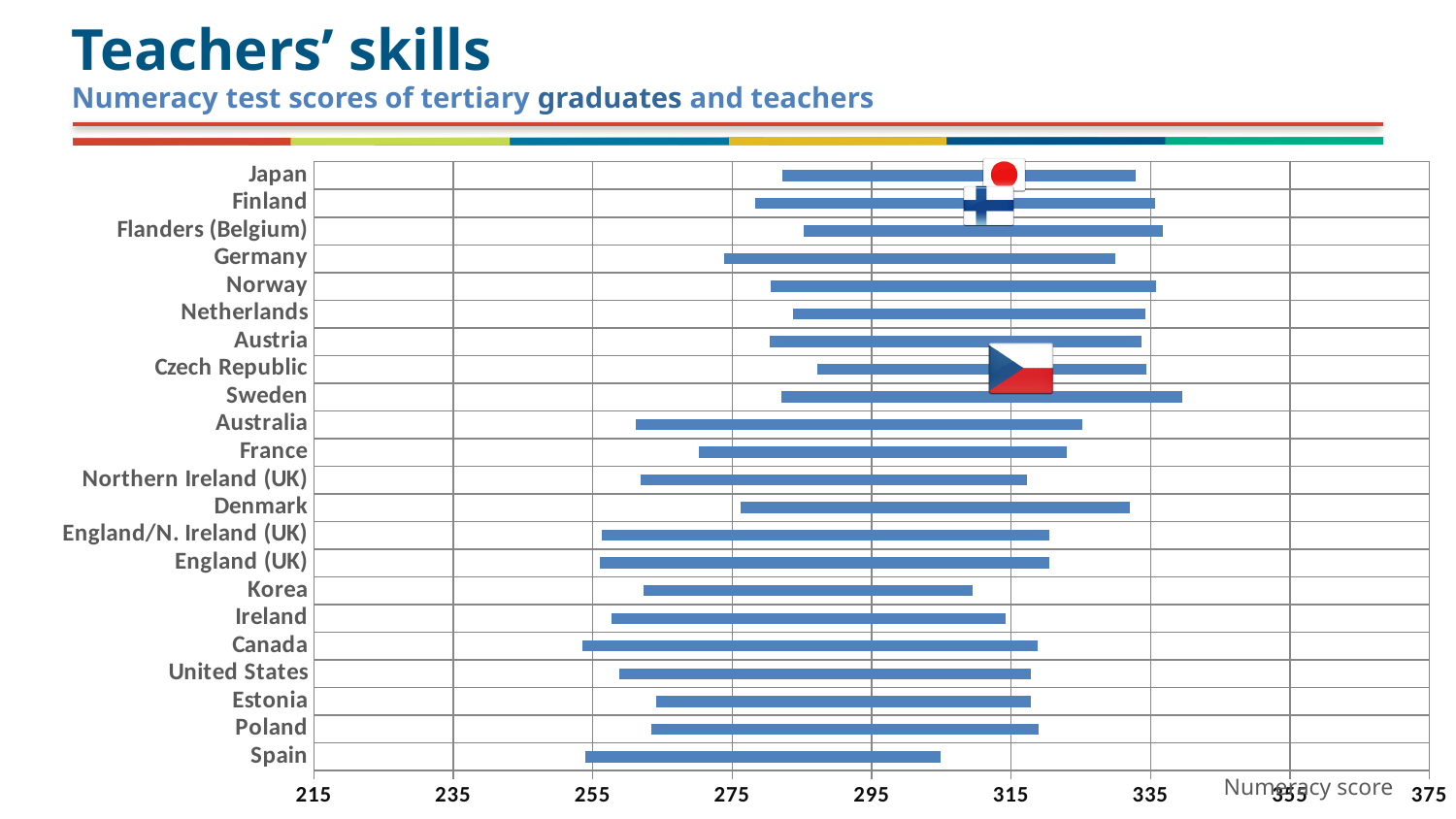
What is the label of the horizontal axis? Numeracy score Which bar starts further to the left, Canada or Japan? Canada Which bar extends further to the right, Sweden or Spain? Sweden What kind of chart is shown on the slide? bar chart What is the subtitle of the chart? Numeracy test scores of tertiary graduates and teachers Which country's bar extends furthest to the right (highest numeracy score)? Sweden How many countries or regions are listed on the vertical axis of the chart? 22 Is the left end of Czech Republic's bar greater or less than 275? greater Which country's bar starts furthest to the left (lowest numeracy score)? Canada Is the right end of Sweden's bar greater or less than 335? greater Is the right end of Spain's bar greater or less than 315? less